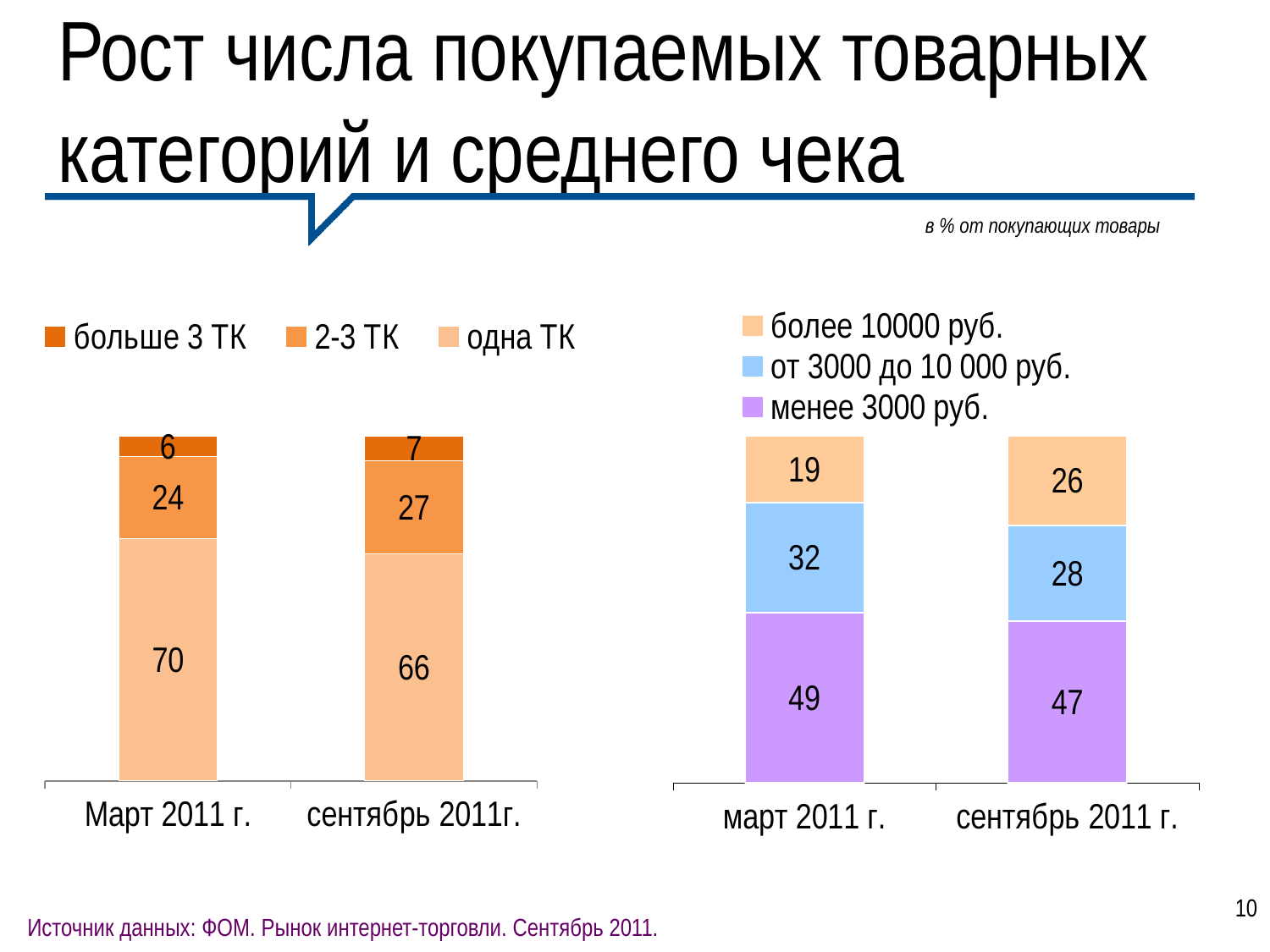
In the left chart, what is the difference between the 'одна ТК' values for Март 2011 г. and сентябрь 2011г.? 4 In the left chart, what is the value for '2-3 ТК' in сентябрь 2011г.? 27 In the left chart, what is the value for 'больше 3 ТК' in Март 2011 г.? 6 In the left chart, what is the value for 'одна ТК' in Март 2011 г.? 70 In the right chart, what is the value for 'более 10000 руб.' in март 2011 г.? 19 In the right chart, which is larger: 'от 3000 до 10 000 руб.' in март 2011 г. or in сентябрь 2011 г.? март 2011 г. In the left chart, which series is shown in the darkest orange colour? больше 3 ТК What kind of chart is the right chart? Stacked bar chart In the right chart, what is the value for 'менее 3000 руб.' in сентябрь 2011 г.? 47 How many series does the legend of the left chart list? 3 In the right chart, what is the total of the stacked bar for март 2011 г.? 100 In the right chart, what is the difference between the 'более 10000 руб.' values for сентябрь 2011 г. and март 2011 г.? 7